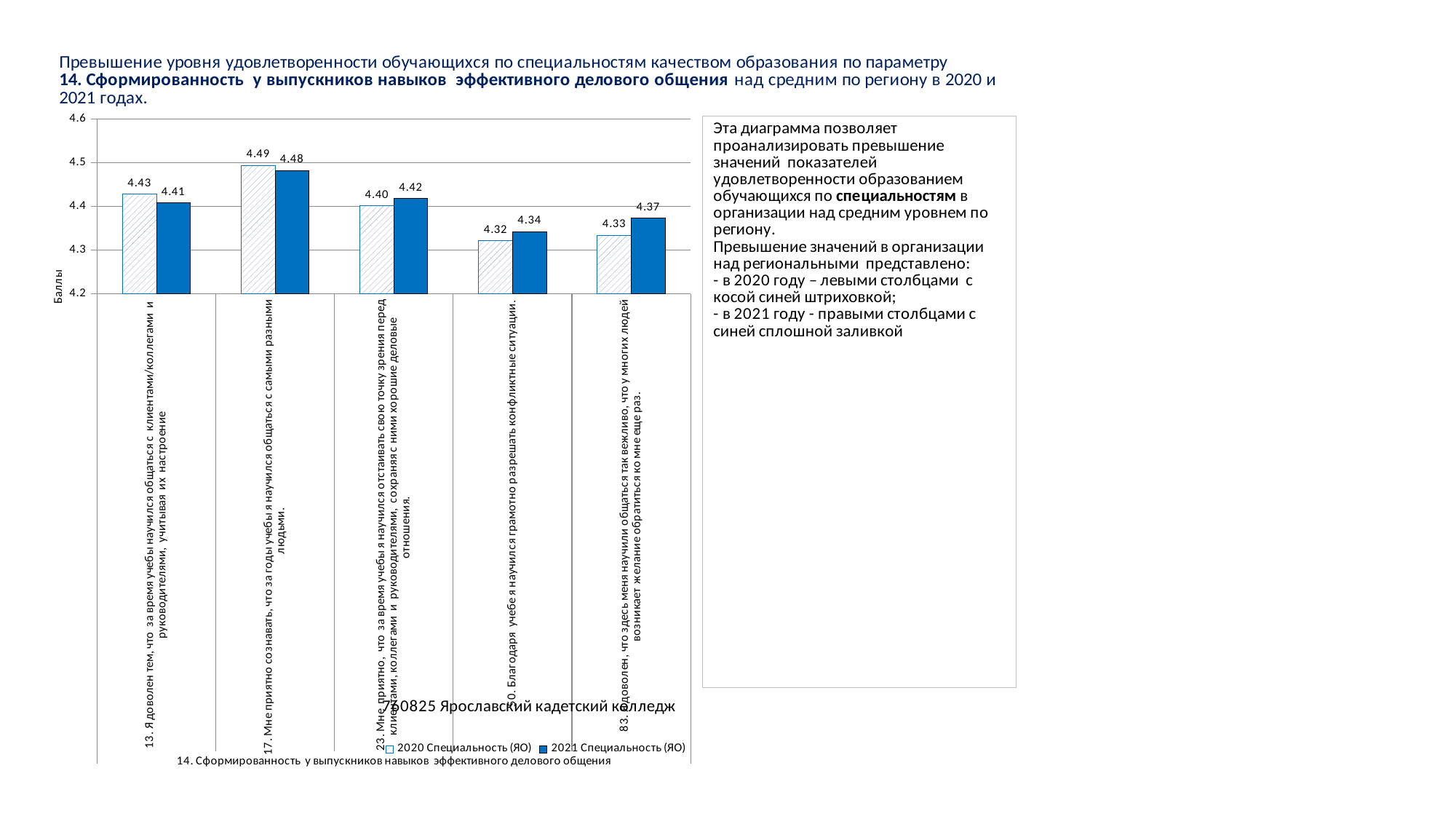
How many statements (categories) are shown on the x axis of the chart? 5 What is the 2020 Специальность (ЯО) value for statement 13 (Я доволен тем, что за время учебы научился общаться с клиентами/коллегами и руководителями)? 4.43 What is the label of the vertical axis of the chart? Баллы What is the 2021 Специальность (ЯО) value for statement 23 (Мне приятно, что за время учебы я научился отстаивать свою точку зрения)? 4.42 Which statement has the highest 2020 Специальность (ЯО) value? 17. Мне приятно сознавать, что за годы учебы я научился общаться с самыми разными людьми What is the 2021 Специальность (ЯО) value for statement 17 (Мне приятно сознавать, что за годы учебы я научился общаться с самыми разными людьми)? 4.48 Is the 2020 Специальность (ЯО) value for the statement about resolving conflict situations (Благодаря учебе я научился грамотно разрешать конфликтные ситуации) greater or less than 4.4? less Which statement has the lowest 2021 Специальность (ЯО) value? Благодаря учебе я научился грамотно разрешать конфликтные ситуации What is the difference between the 2021 and 2020 Специальность (ЯО) values for statement 83 (Я доволен, что здесь меня научили общаться так вежливо)? 0.04 For statement 13, which is larger: the 2020 Специальность (ЯО) value or the 2021 Специальность (ЯО) value? 2020 Специальность (ЯО) What type of chart is shown on the slide? bar chart How many series does the chart legend list? 2